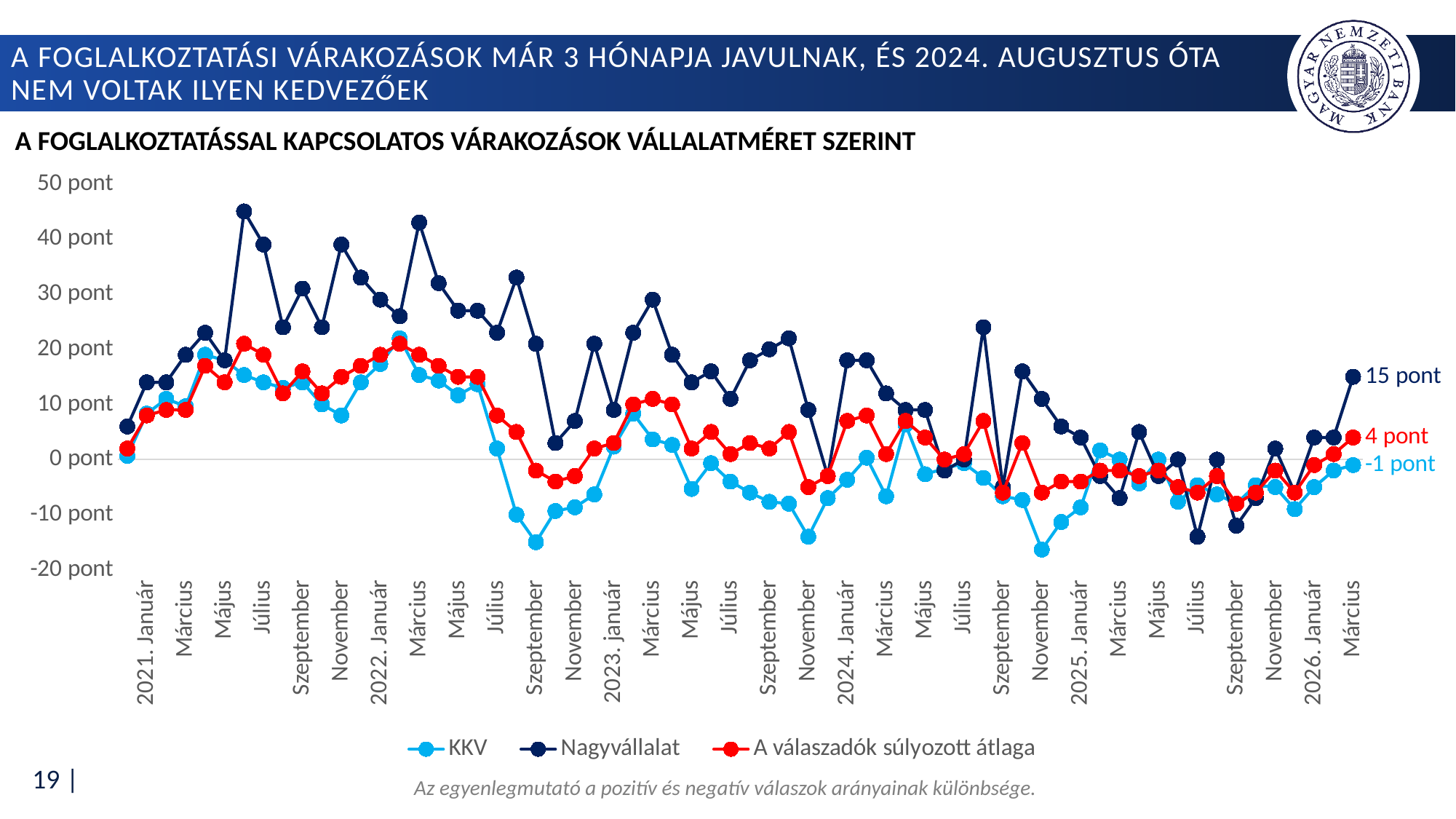
At the last point (2026 Március), which series has the higher value: KKV or Nagyvállalat? Nagyvállalat What is the value of 'A válaszadók súlyozott átlaga' at the last point (2026 Március)? 4 pont Is the Nagyvállalat value at 2021 November greater or less than 30 pont? greater What is the value of the Nagyvállalat series at the last point (2026 Március)? 15 pont What is the title of the chart? A FOGLALKOZTATÁSSAL KAPCSOLATOS VÁRAKOZÁSOK VÁLLALATMÉRET SZERINT Which series has the lowest value at the last point (2026 Március)? KKV Is the KKV value at 2022 Szeptember greater or less than -10 pont? less How many series does the legend list? 3 At the last point (2026 Március), what is the difference between the Nagyvállalat value and the súlyozott átlaga value? 11 pont At the last point (2026 Március), what is the difference between the Nagyvállalat value and the KKV value? 16 pont What is the value of the KKV series at the last point (2026 Március)? -1 pont What kind of chart is shown on the slide? Line chart